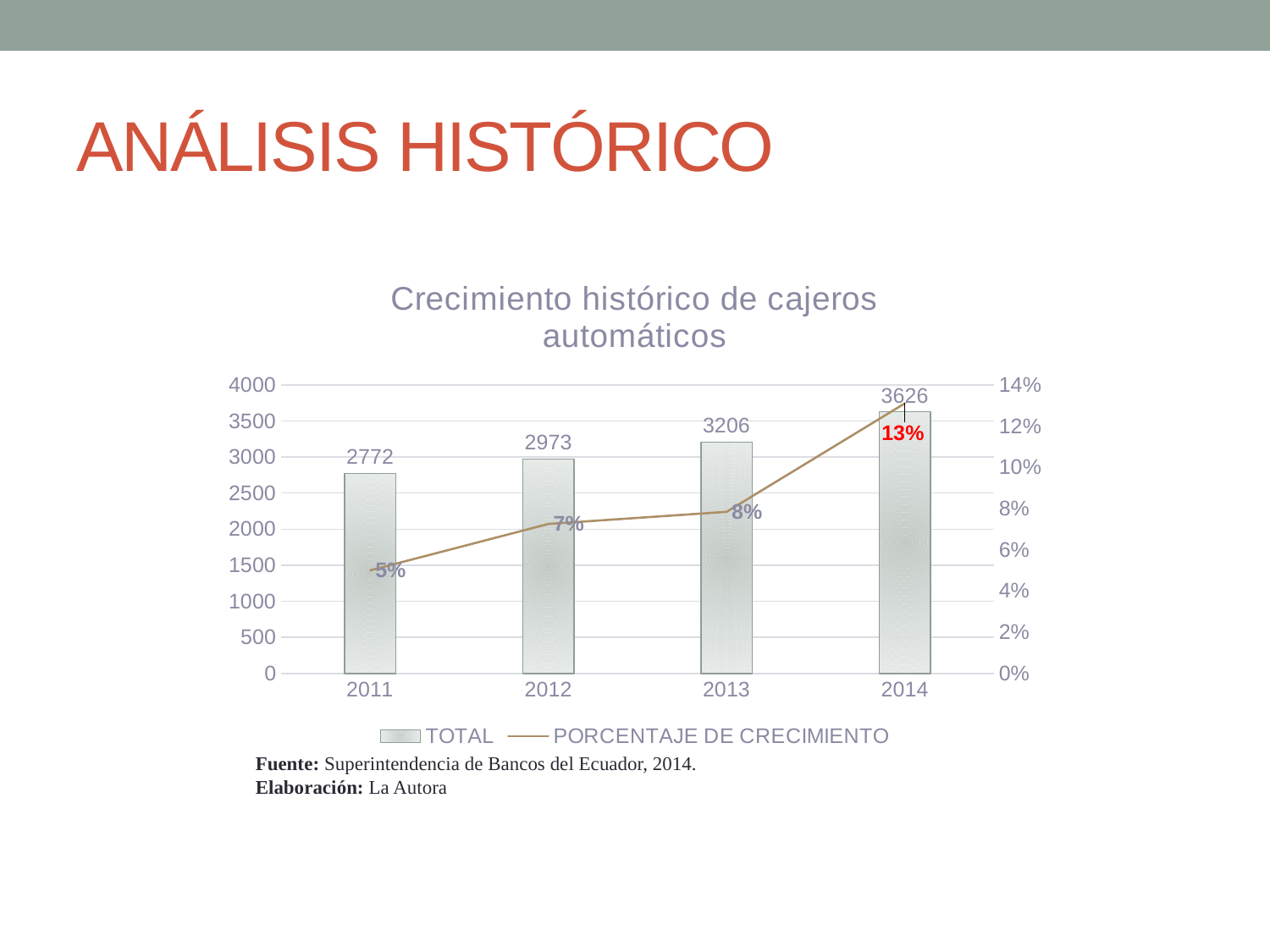
What is the difference between the TOTAL values for 2014 and 2013? 420 How many series does the legend list? 2 What is the title of the chart? Crecimiento histórico de cajeros automáticos Which is larger, the TOTAL value for 2012 or for 2013? 2013 What is the TOTAL value for 2014? 3626 Which year has the lowest PORCENTAJE DE CRECIMIENTO value? 2011 What is the PORCENTAJE DE CRECIMIENTO value for 2014? 13% How many years are shown on the x axis? 4 What is the PORCENTAJE DE CRECIMIENTO value for 2013? 8% What is the TOTAL value for 2011? 2772 Which year has the highest TOTAL value? 2014 Does the TOTAL value rise or fall from 2011 to 2014? rise